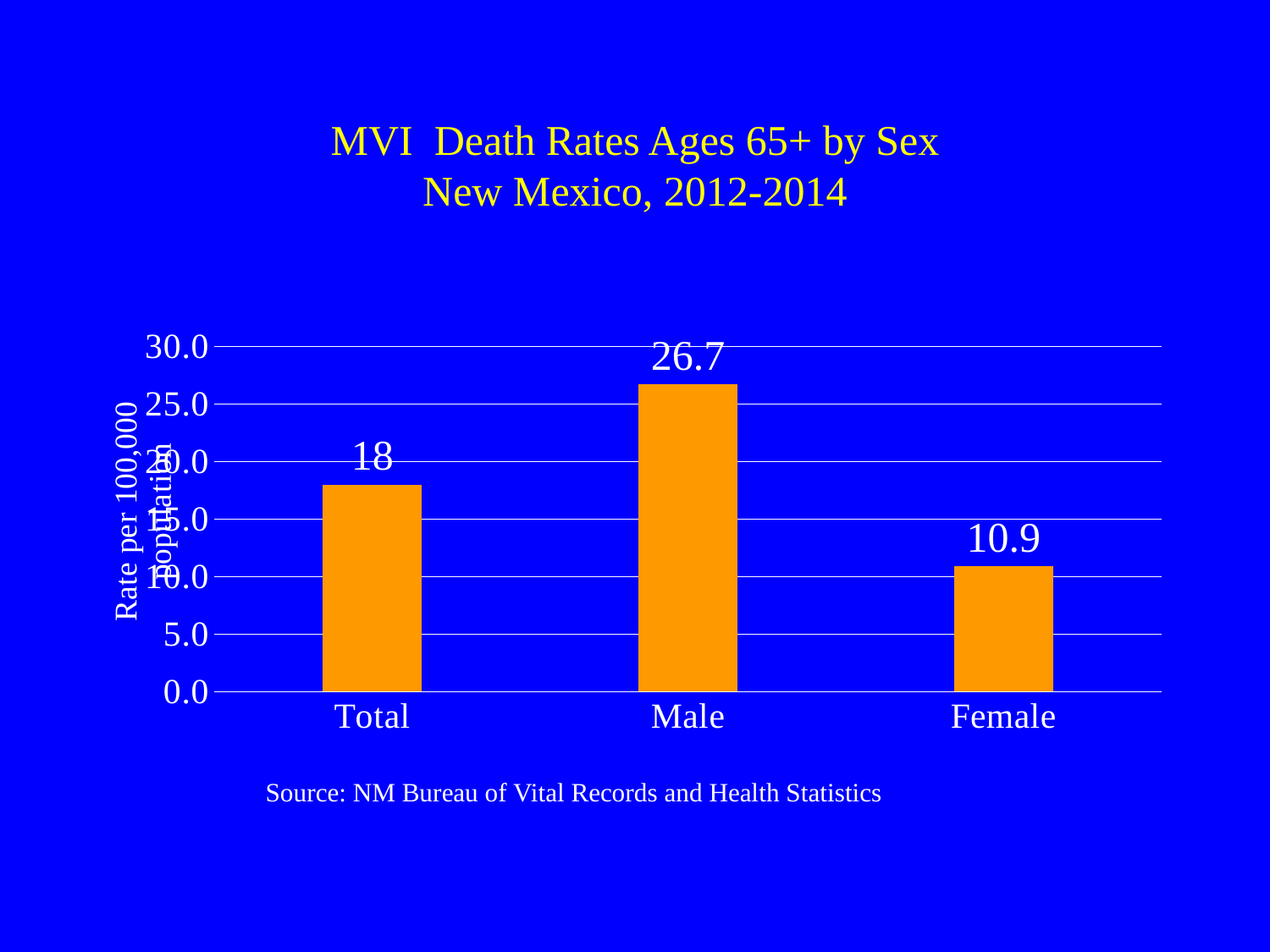
What is the MVI death rate for Male? 26.7 What is the MVI death rate for Female? 10.9 What is the title of the chart? MVI Death Rates Ages 65+ by Sex New Mexico, 2012-2014 What is the difference between the Male and Female death rates? 15.8 Which is larger, the death rate for Total or for Female? Total What kind of chart is shown on the slide? bar chart Which category has the lowest death rate? Female What is the difference between the Male and Total death rates? 8.7 Which category has the highest death rate? Male How many categories are shown on the x axis? 3 Is the value for Male greater or less than 25.0? greater What is the MVI death rate for Total? 18